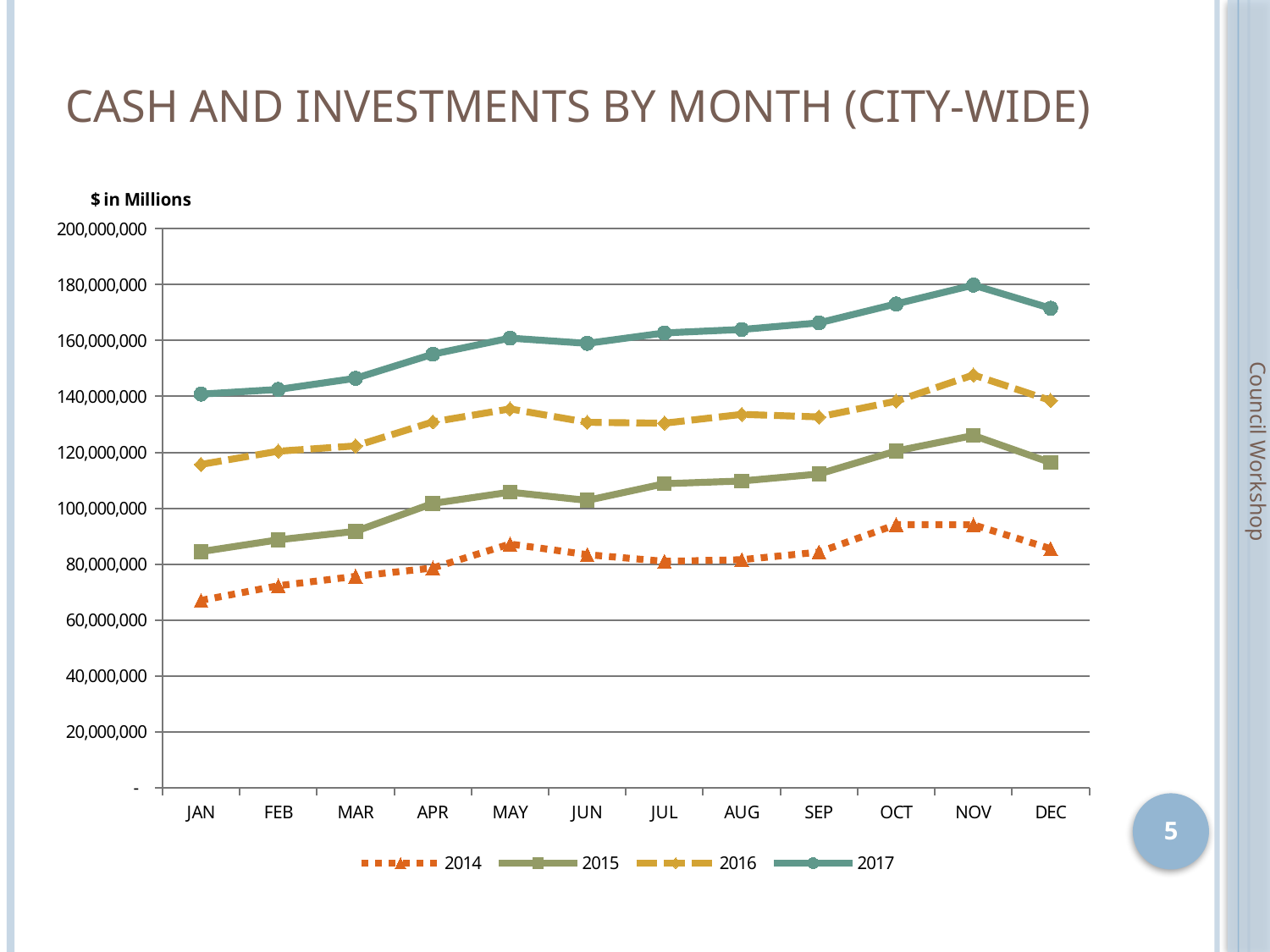
Does the 2017 series generally rise or fall from JAN to NOV? rise How many months are plotted along the x axis? 12 In which month does the 2016 series reach its highest value? NOV In which month is the 2014 series at its lowest value? JAN What label is shown above the vertical axis? $ in Millions What kind of chart is shown on the slide? Line chart Is the value for 2014 in JAN greater or less than 80,000,000? less Is the value for 2015 in MAY greater or less than 100,000,000? greater Is the value for 2017 in NOV greater or less than 160,000,000? greater In which month does the 2017 series reach its highest value? NOV How many series does the legend list? 4 Which series has the larger value in NOV, 2016 or 2015? 2016